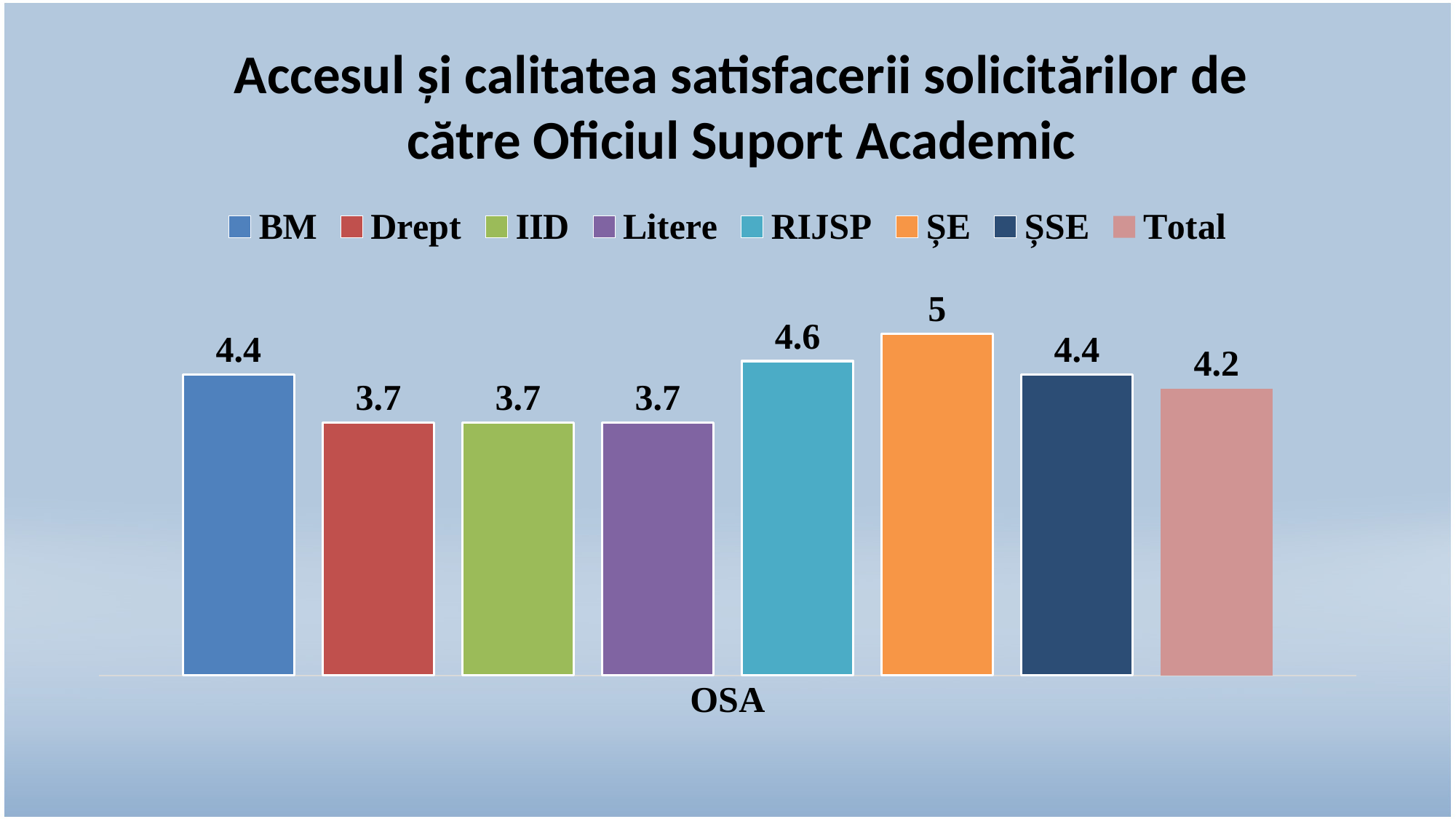
What kind of chart is shown on the slide? Bar chart What is the value for Total? 4.2 What is the difference between the values for RIJSP and Litere? 0.9 What is the category label shown on the x axis? OSA What is the value for Drept? 3.7 Which series has the highest value? ȘE What is the value for BM? 4.4 What is the value for RIJSP? 4.6 How many series does the legend list? 8 Which is larger, the value for ȘSE or the value for IID? ȘSE Which is larger, the value for RIJSP or the value for Total? RIJSP What is the difference between the values for ȘE and Total? 0.8